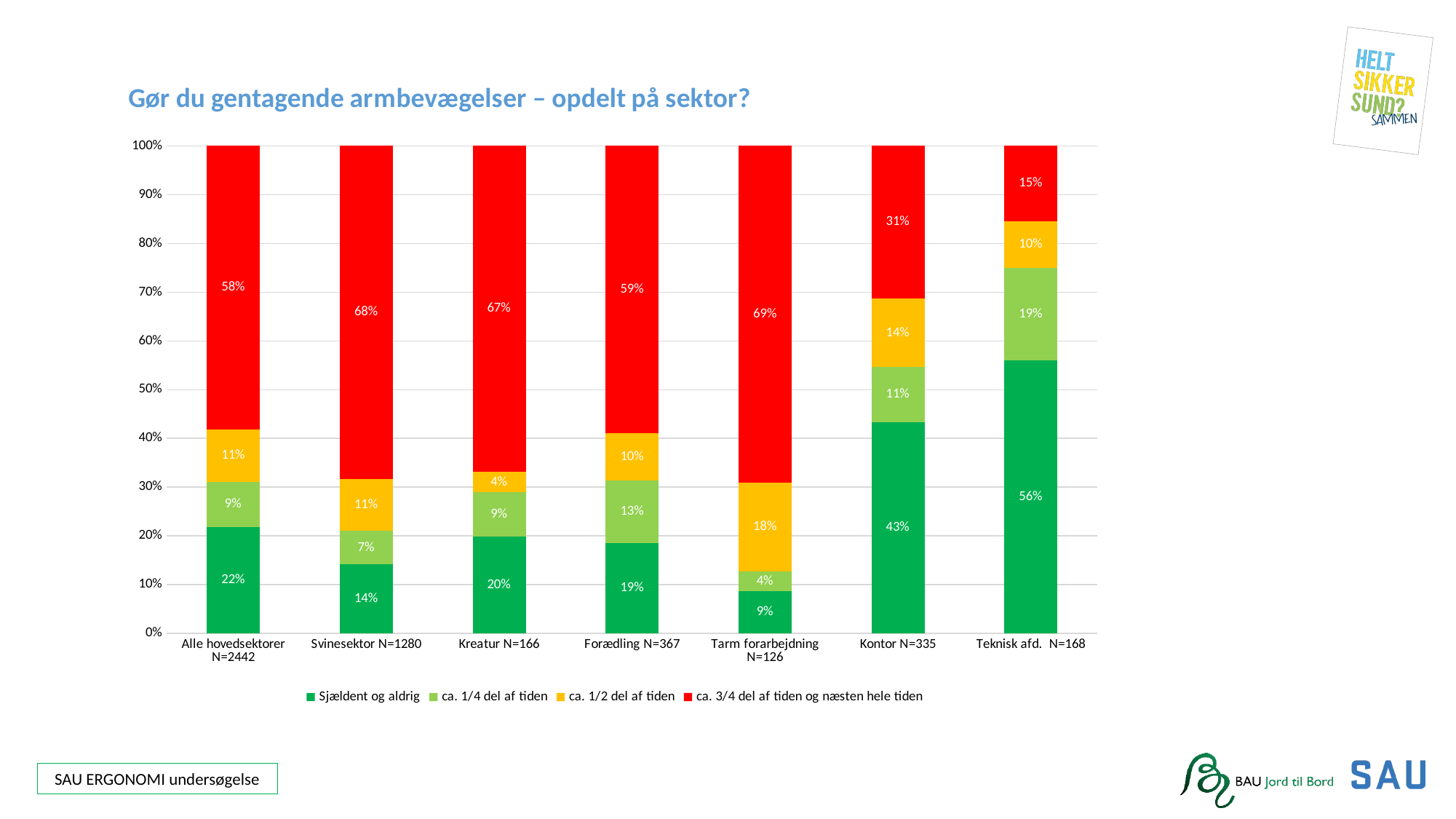
How many sectors (categories) are shown on the x axis? 7 What is the value of "ca. 1/4 del af tiden" for Forædling N=367? 13% What kind of chart is shown on the slide? Stacked bar chart What is the difference between the "ca. 3/4 del af tiden og næsten hele tiden" values for Svinesektor N=1280 and Alle hovedsektorer N=2442? 10 percentage points What percentage of respondents in Tarm forarbejdning N=126 answered "ca. 3/4 del af tiden og næsten hele tiden"? 69% Which sector has the highest value for "Sjældent og aldrig"? Teknisk afd. N=168 What is the value of "Sjældent og aldrig" for Kontor N=335? 43% How many series does the legend list? 4 Which is larger: the "Sjældent og aldrig" value for Kreatur N=166 or for Svinesektor N=1280? Kreatur N=166 Which sector has the lowest value for "ca. 3/4 del af tiden og næsten hele tiden"? Teknisk afd. N=168 What is the value of "ca. 1/2 del af tiden" for Kreatur N=166? 4% Which colour represents "ca. 1/2 del af tiden" in the chart? Yellow